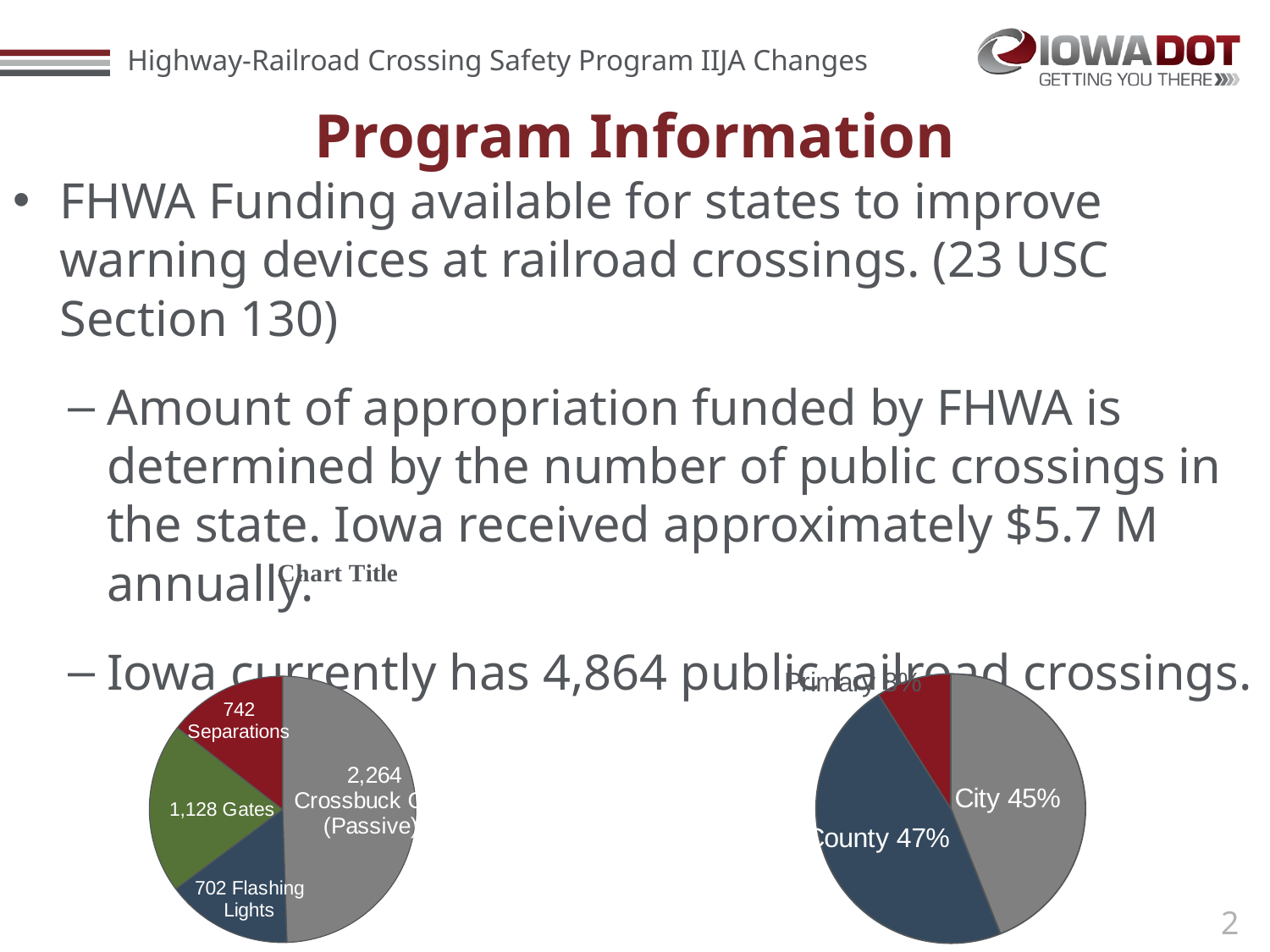
In the right pie chart, what share is shown for County? 47% In the left pie chart, which category has the smallest value? Flashing Lights How many slices does the left pie chart have? 4 In the left pie chart, what is the value for Gates? 1,128 In the left pie chart, which category has the largest value? Crossbuck (Passive) In the left pie chart, what is the value for Flashing Lights? 702 In the left pie chart, which is larger: Separations or Flashing Lights? Separations In the left pie chart, what is the difference between the Crossbuck (Passive) value and the Gates value? 1,136 In the left pie chart, what is the value for Crossbuck (Passive)? 2,264 What kind of chart is the left chart on the slide? pie chart How many slices does the right pie chart have? 3 In the right pie chart, what share is shown for City? 45%